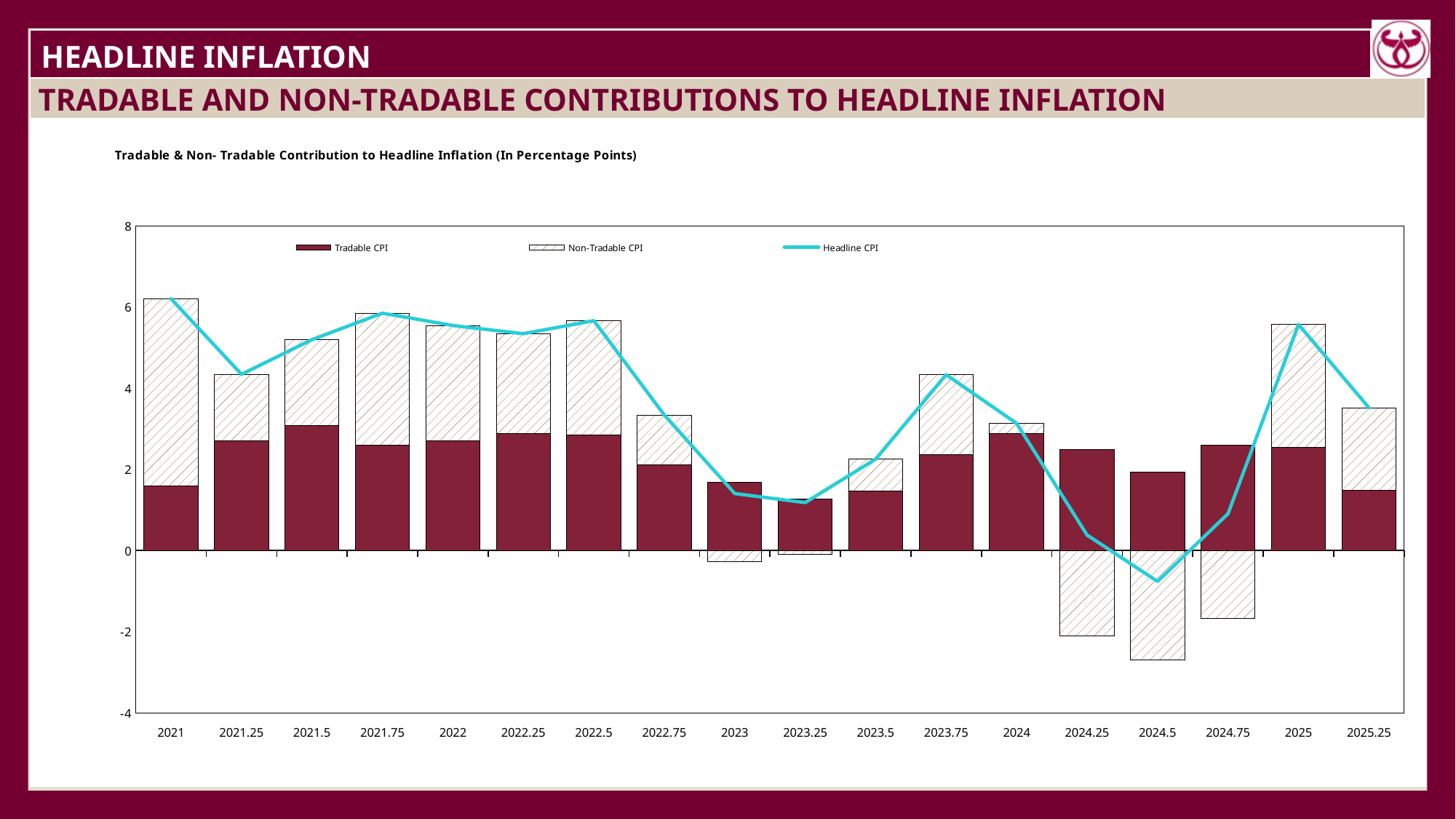
What is the title of the chart? Tradable & Non- Tradable Contribution to Headline Inflation (In Percentage Points) How many time periods are shown on the x axis? 18 Is the Headline CPI value for 2023.25 greater or less than 2? less How many series does the legend list? 3 Is the Non-Tradable CPI contribution for 2024.5 greater or less than -2? less Is the Tradable CPI contribution for 2021 greater or less than 2? less In which period is the Headline CPI line at its highest? 2021 Does the Headline CPI line rise or fall from 2022.5 to 2023.25? fall What kind of chart is shown on the slide? A combination chart with stacked bars and a line In which period is the Headline CPI line at its lowest? 2024.5